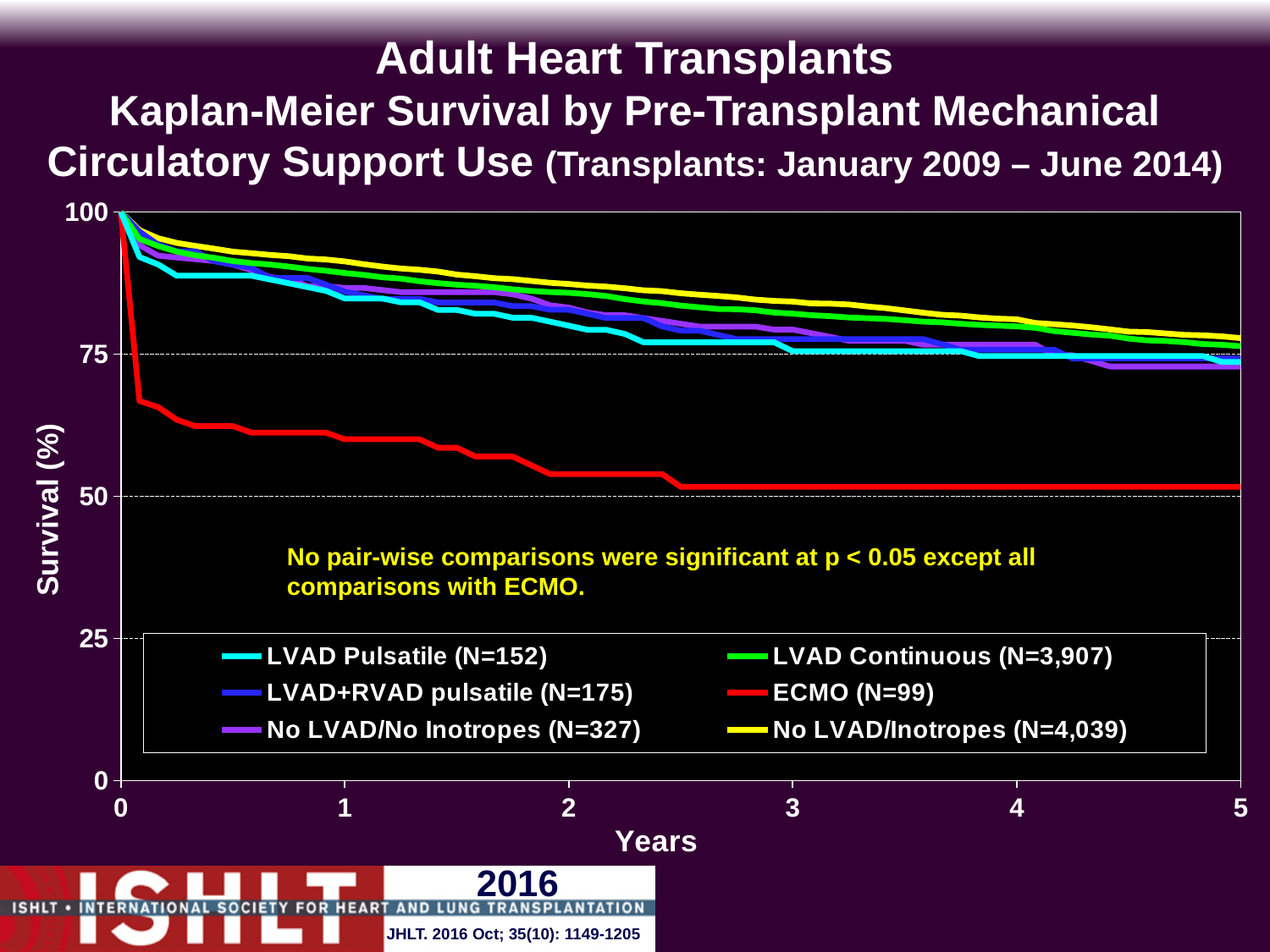
Which group has the highest survival curve at 5 years? No LVAD/Inotropes Is the survival value for ECMO at 1 year greater or less than 50? greater Is the survival value for LVAD Pulsatile at 2 years greater or less than 75? greater What kind of chart is shown on the slide? line chart Do the survival curves rise or fall as years increase? fall How many series does the legend list? 6 Is the survival value for No LVAD/Inotropes at 3 years greater or less than 75? greater At 2 years, which group has higher survival: ECMO or LVAD Continuous? LVAD Continuous What is the N for the ECMO group shown in the legend? 99 What is the label of the y axis? Survival (%) Which group has the lowest survival curve throughout the follow-up period? ECMO